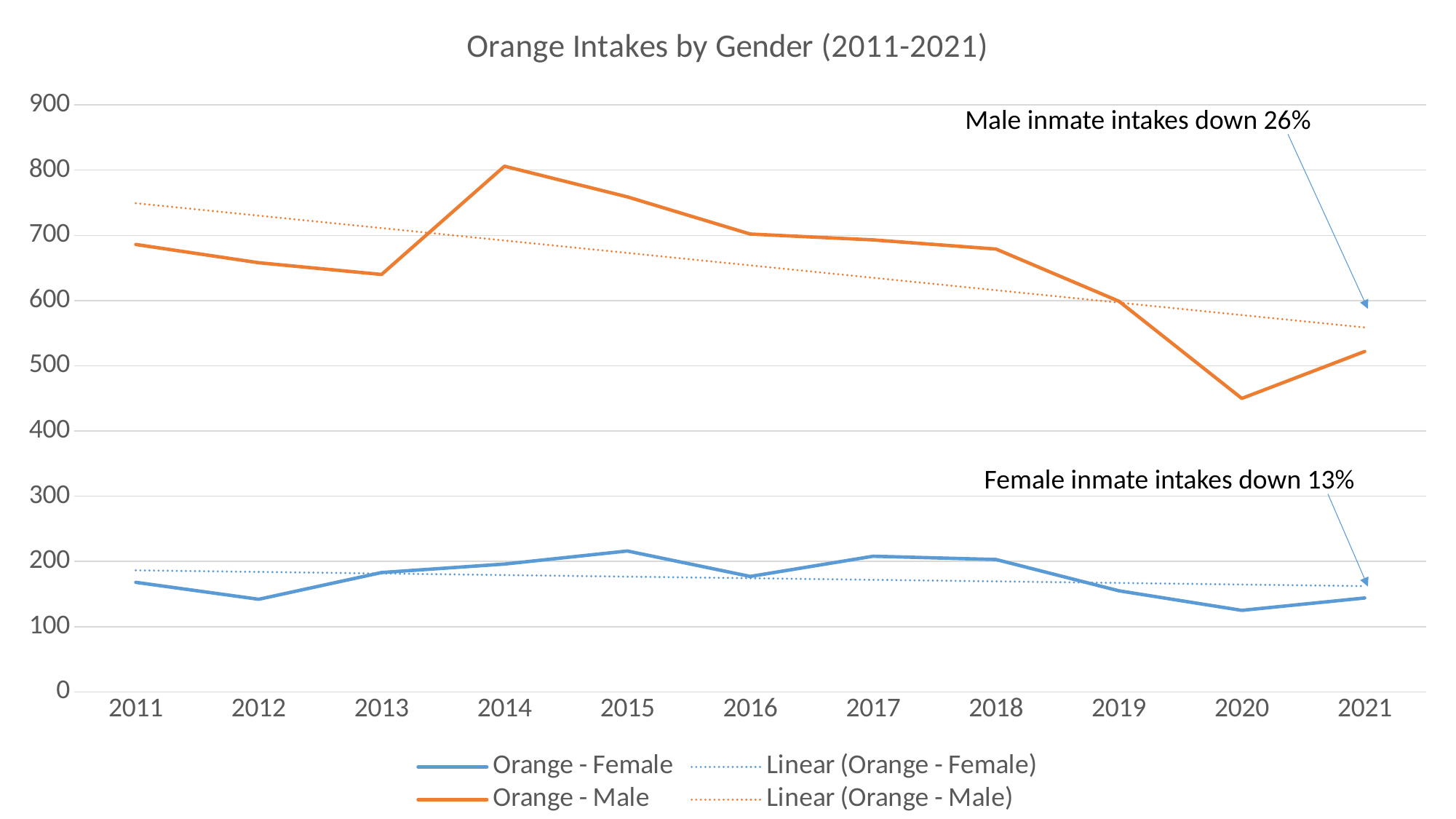
In which year does the Orange - Male series reach its highest value? 2014 Is the value for Orange - Male in 2020 greater or less than 500? less Is the value for Orange - Female in 2020 greater or less than 150? less Does the Linear (Orange - Male) trend line rise or fall from 2011 to 2021? fall In which year does the Orange - Female series reach its lowest value? 2020 In which year does the Orange - Male series reach its lowest value? 2020 How many entries does the legend list? 4 What is the title of the chart? Orange Intakes by Gender (2011-2021) What kind of chart is shown on the slide? line chart Is the value for Orange - Male in 2014 greater or less than 700? greater How many years are shown on the x axis? 11 Which series has the larger value in 2016, Orange - Male or Orange - Female? Orange - Male